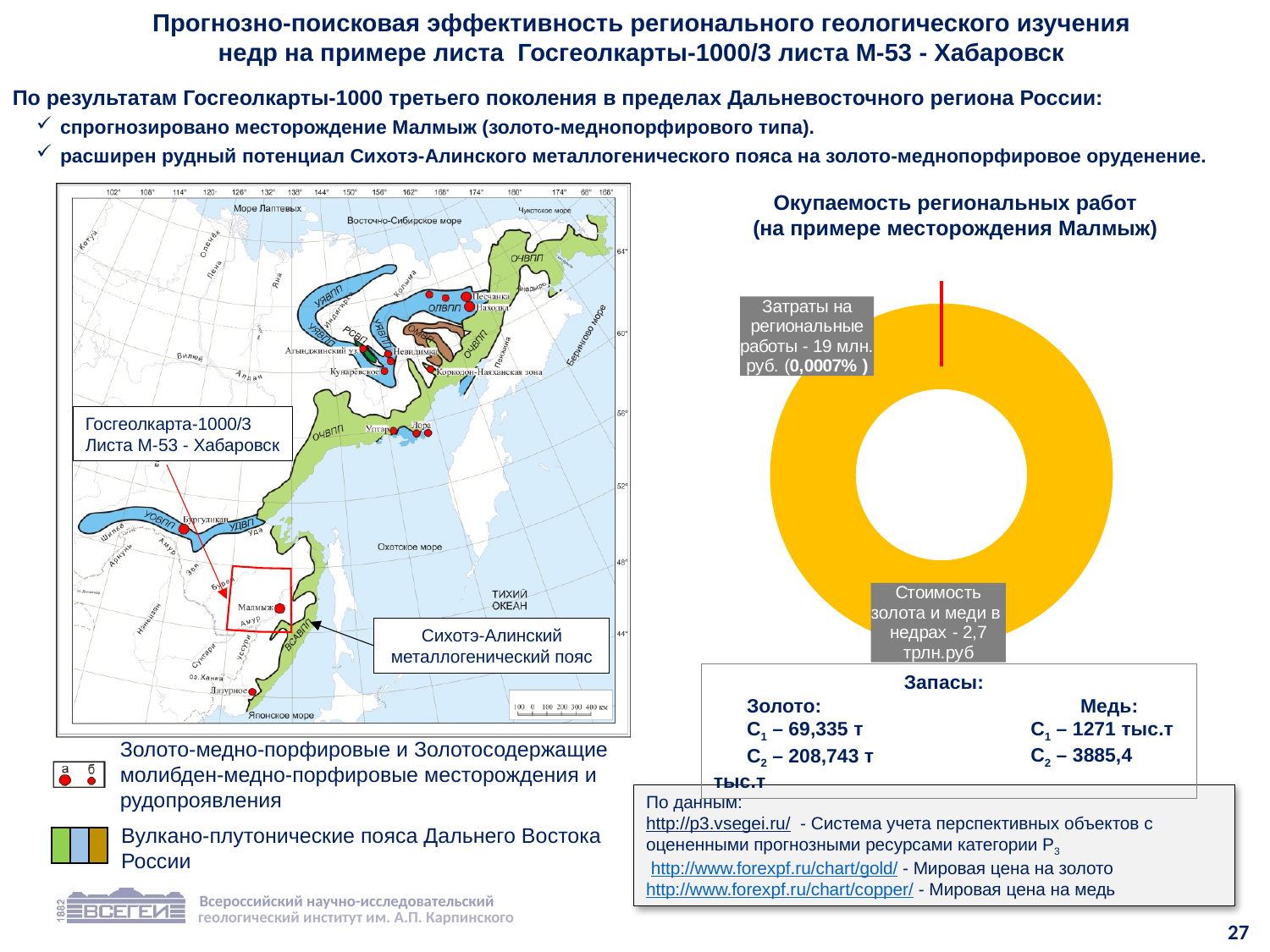
In the chart "Окупаемость региональных работ", which segment is the smallest? Затраты на региональные работы In the chart "Окупаемость региональных работ", which segment is the largest? Стоимость золота и меди в недрах In the chart "Окупаемость региональных работ", which segment is larger: "Затраты на региональные работы" or "Стоимость золота и меди в недрах"? Стоимость золота и меди в недрах What is the title of the chart on the right side of the slide? Окупаемость региональных работ (на примере месторождения Малмыж) What kind of chart is shown under the title "Окупаемость региональных работ (на примере месторождения Малмыж)"? Doughnut (pie) chart How many segments does the doughnut chart "Окупаемость региональных работ" have? 2 In the chart "Окупаемость региональных работ", what share of the doughnut do the regional work costs ("Затраты на региональные работы") represent? 0,0007% What colour is the large segment of the doughnut chart "Окупаемость региональных работ"? Yellow In the chart "Окупаемость региональных работ", what is the value of "Стоимость золота и меди в недрах"? 2,7 трлн.руб In the chart "Окупаемость региональных работ", what is the value of "Затраты на региональные работы"? 19 млн. руб.